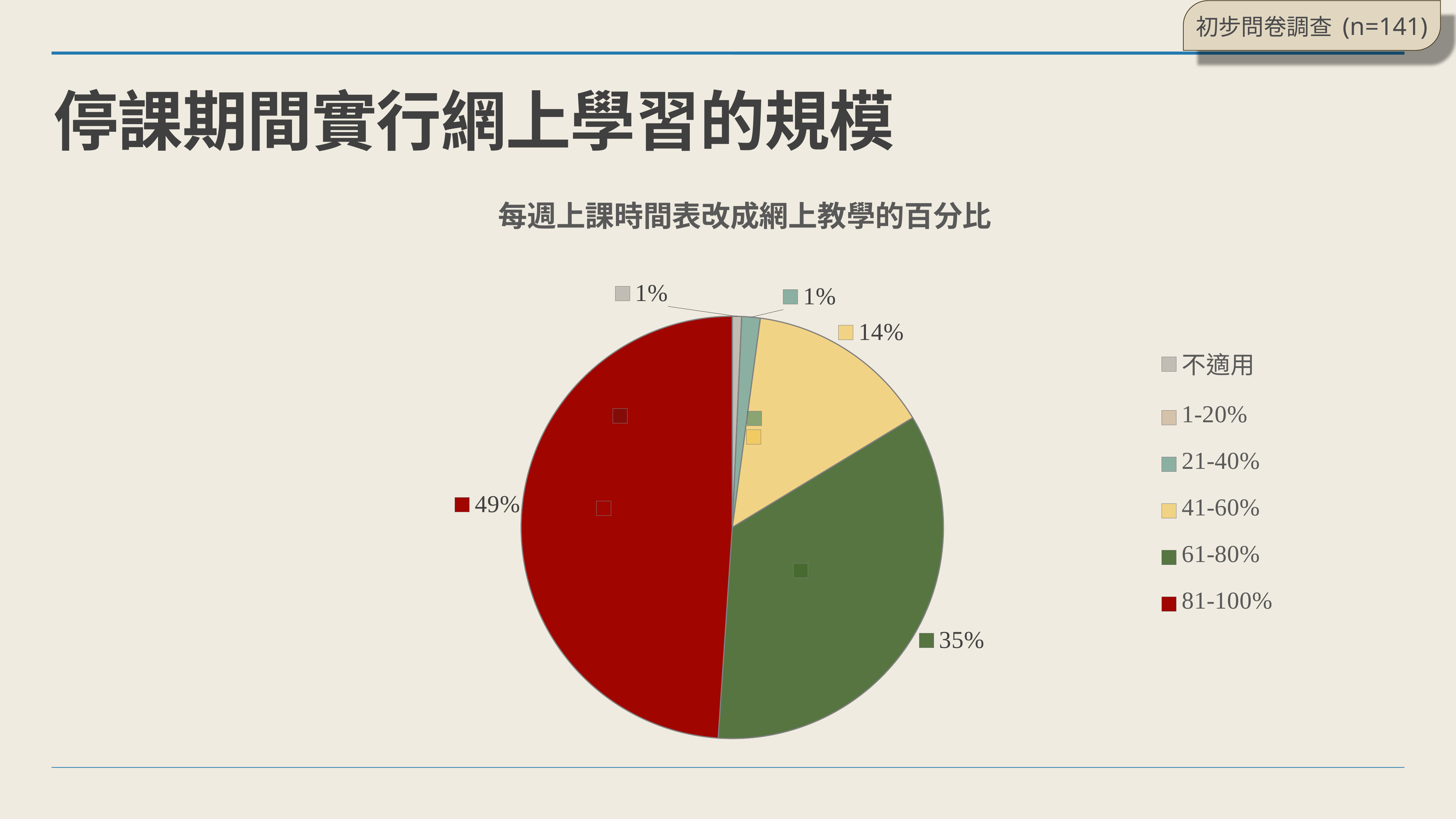
What percentage is shown for the 21-40% category? 1% What type of chart is shown on the slide? pie chart What percentage is shown for the 81-100% category? 49% What percentage is shown for the 不適用 category? 1% What is the difference between the 61-80% slice and the 41-60% slice? 21 percentage points What percentage is shown for the 61-80% category? 35% Which is larger, the 61-80% slice or the 41-60% slice? 61-80% What is the difference between the 81-100% slice and the 61-80% slice? 14 percentage points How many categories does the legend list? 6 What percentage is shown for the 41-60% category? 14% Which category has the largest slice of the pie? 81-100% What is the title of the chart? 每週上課時間表改成網上教學的百分比